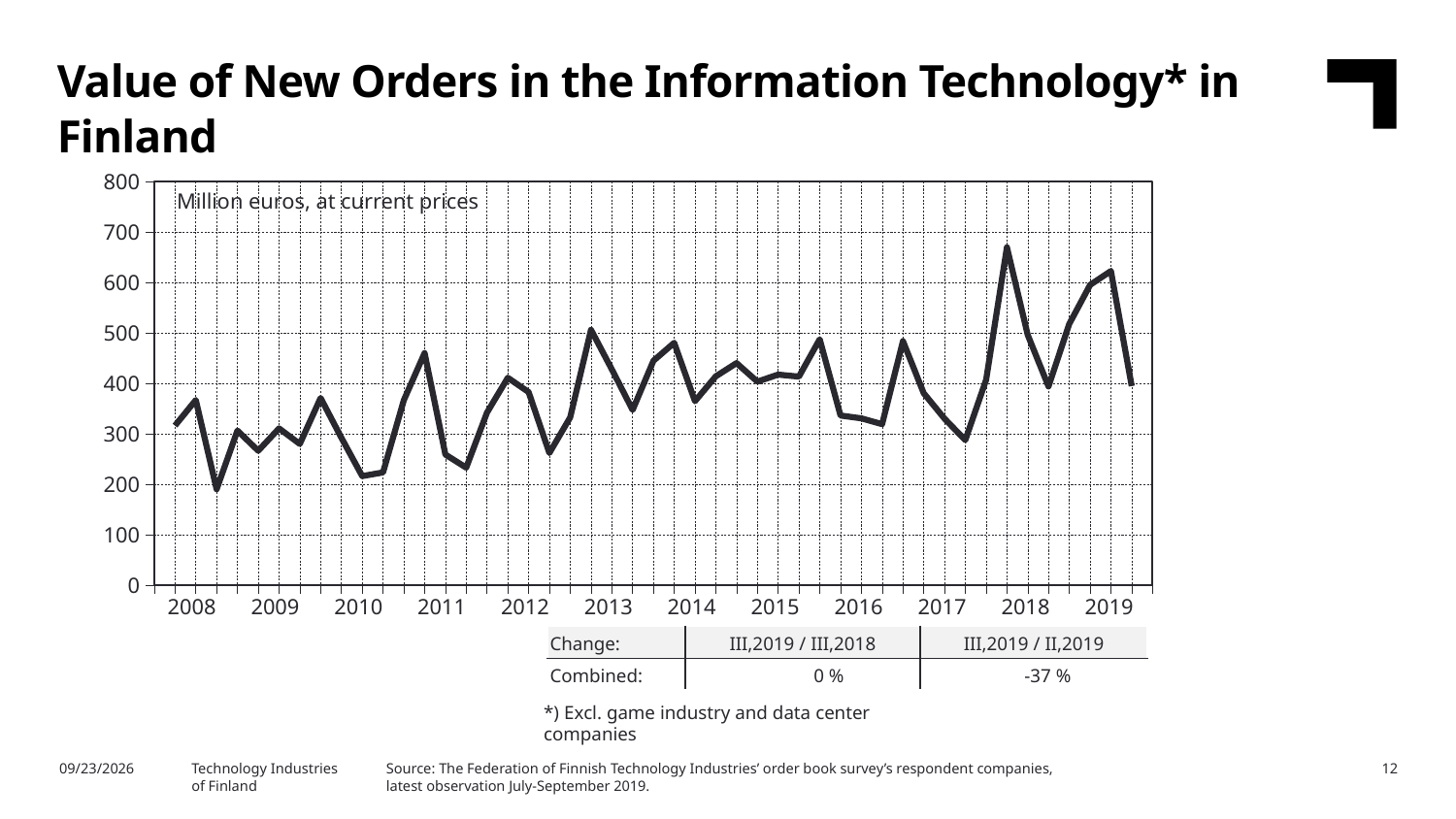
Is the peak in 2018 higher or lower than the peak in 2011? higher What is the highest value shown on the vertical axis? 800 In which year does the line reach its highest peak? 2018 What kind of chart is shown on the slide? line chart Is the highest peak of the line, in 2018, greater or less than 600? greater What is the title of the chart? Value of New Orders in the Information Technology* in Finland Is the peak value in 2013 greater or less than 400? greater In which year does the line reach its lowest point? 2008 Is the lowest point of the line, in 2008, greater or less than 300? less Does the line rise or fall between the 2018 peak and the end of 2018? fall In what unit are the values on the chart expressed? Million euros, at current prices